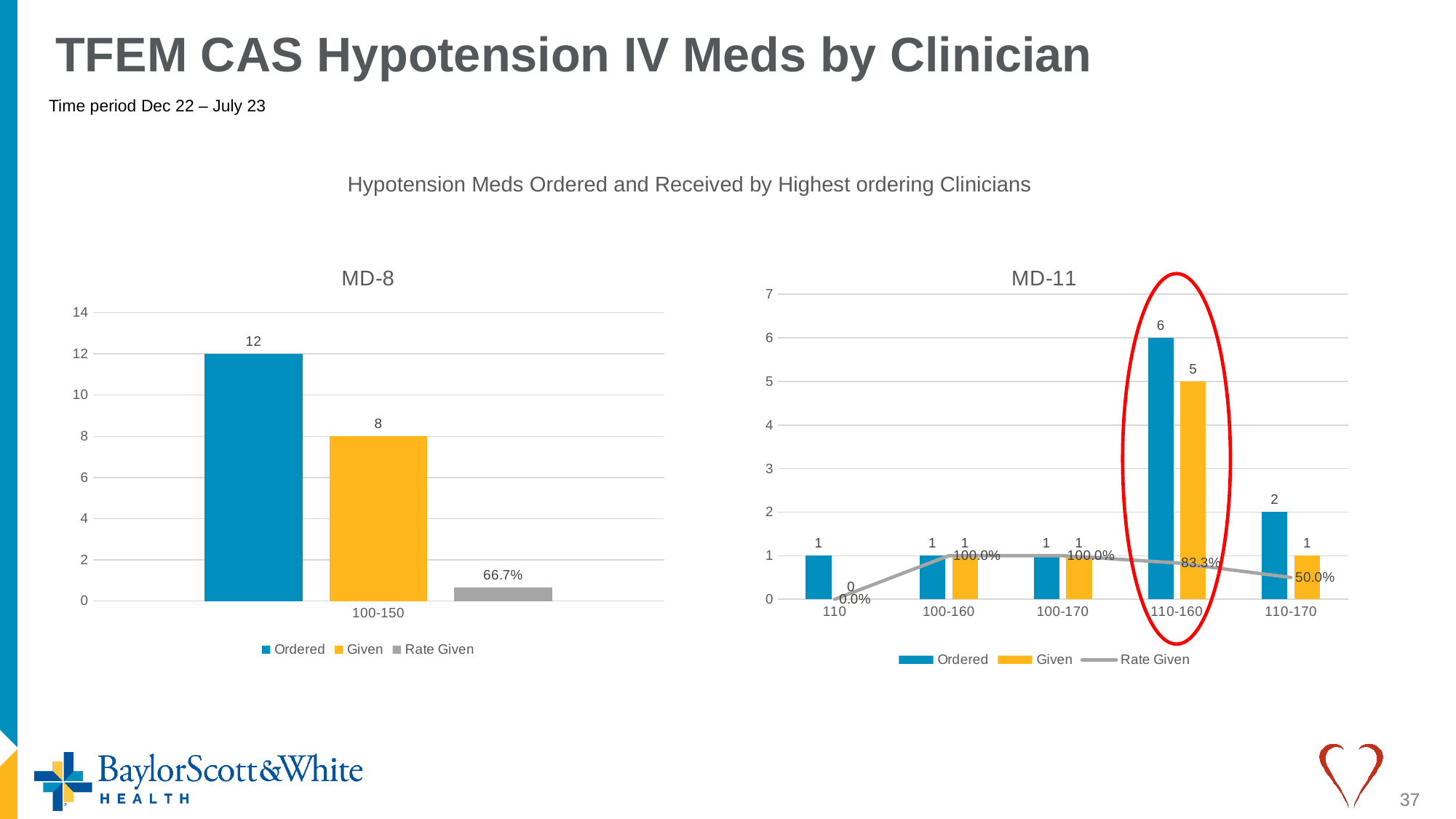
In the MD-11 chart, is the Ordered value for 110-160 larger or smaller than the Ordered value for 110-170? larger In the MD-11 chart, which category has the lowest Given value? 110 In the MD-8 chart, what is the Ordered value for 100-150? 12 In the MD-8 chart, what is the Rate Given for 100-150? 66.7% In the MD-8 chart, what is the difference between the Ordered and Given values for 100-150? 4 In the MD-11 chart, what is the Given value for 110-160? 5 In the MD-11 chart, which category has the highest Ordered value? 110-160 In the MD-11 chart, what is the Ordered value for 110-160? 6 In the MD-8 chart, what is the Given value for 100-150? 8 In the MD-11 chart, how many categories are shown on the x axis? 5 In the MD-11 chart, what is the Rate Given for 110-170? 50.0% In the MD-11 chart, how many series does the legend list? 3